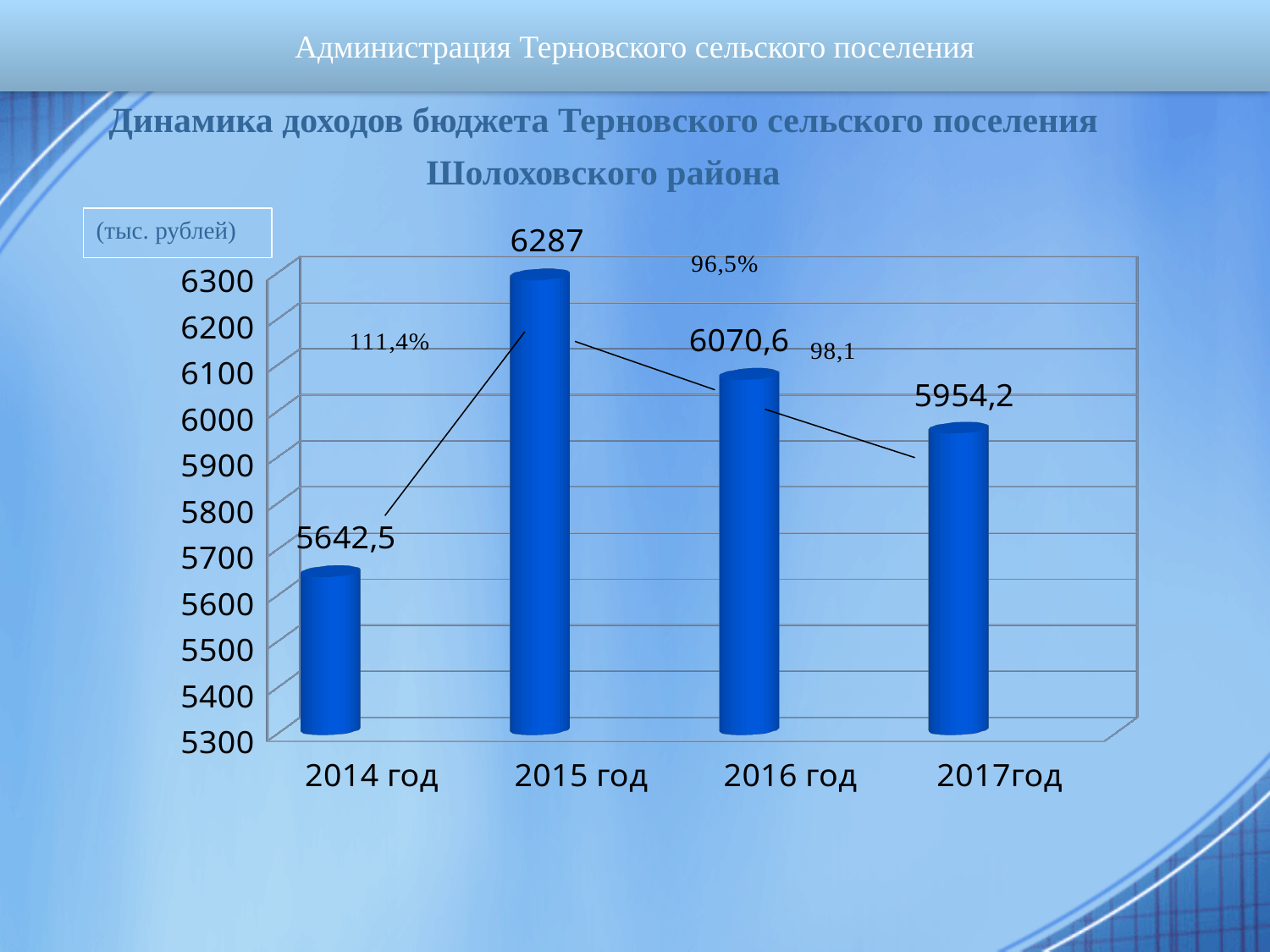
What is the value shown for 2017год? 5954,2 Which is larger, the value for 2016 год or the value for 2017год? 2016 год Which year has the highest budget income? 2015 год What kind of chart is shown on the slide? bar chart Do the values rise or fall from 2015 год to 2017год? fall Is the value for 2014 год greater or less than 5700? less What is the difference between the values for 2015 год and 2016 год? 216,4 What is the value shown for 2014 год? 5642,5 Which year has the lowest budget income? 2014 год What is the budget income value shown for 2015 год? 6287 How many years are shown on the chart? 4 In what units are the chart values given? тыс. рублей